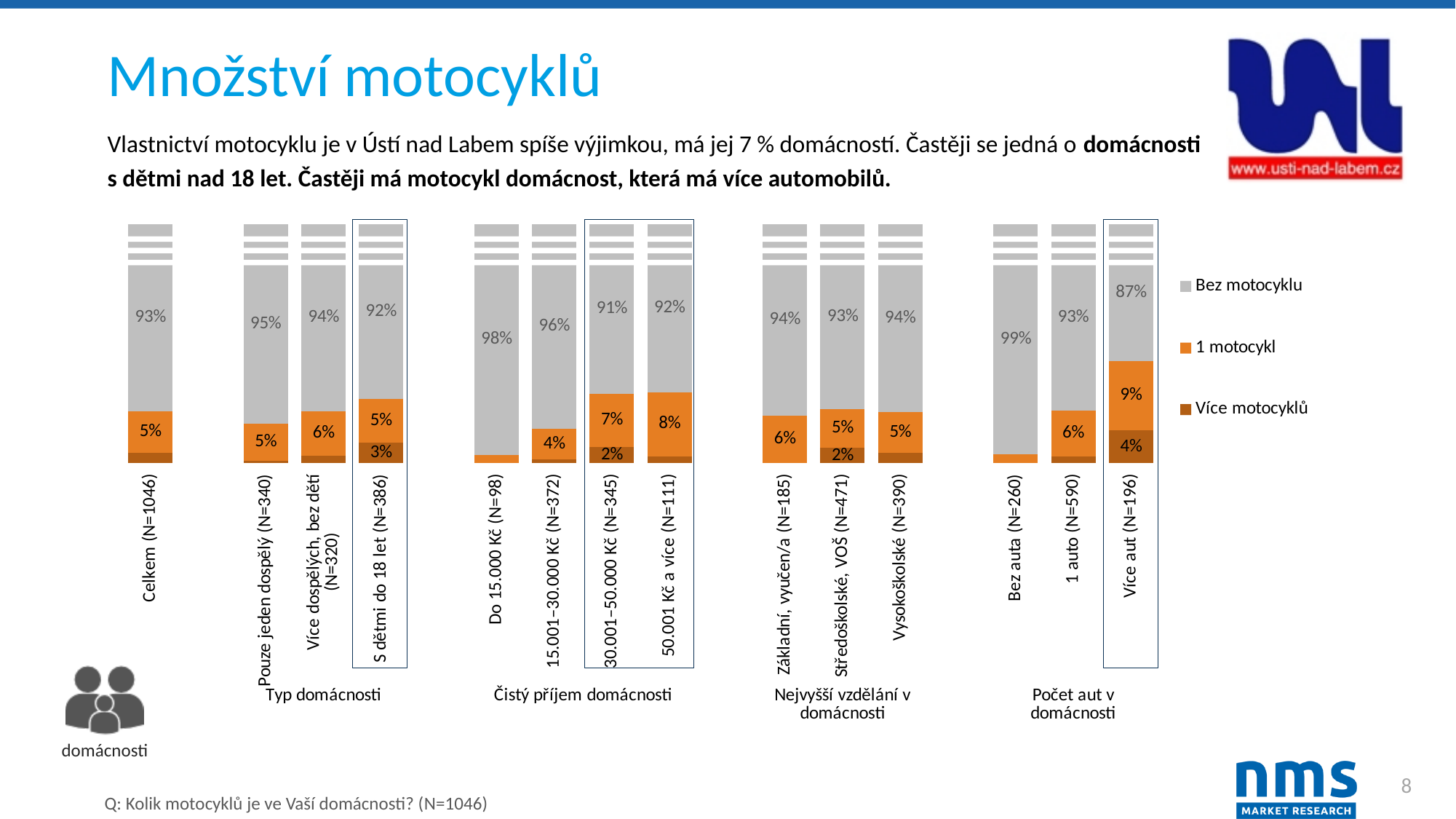
What is the '1 motocykl' value for the 'Více aut (N=196)' bar? 9% Which bar has the highest 'Bez motocyklu' share? Bez auta (N=260) How many series does the legend list? 3 How many bars are plotted in the chart in total? 14 Which legend entry is shown in grey? Bez motocyklu What is the difference in the 'Bez motocyklu' share between 'Bez auta (N=260)' and 'Více aut (N=196)'? 12% What kind of chart is shown on the slide? Stacked bar chart Which bar has the lowest 'Bez motocyklu' share? Více aut (N=196) What is the 'Bez motocyklu' value for the 'Do 15.000 Kč (N=98)' bar? 98% What percentage of households in the 'Celkem (N=1046)' bar have no motorcycle (Bez motocyklu)? 93% Which has a larger '1 motocykl' share: '30.001–50.000 Kč (N=345)' or '50.001 Kč a více (N=111)'? 50.001 Kč a více (N=111) What is the 'Více motocyklů' value for the 'S dětmi do 18 let (N=386)' bar? 3%